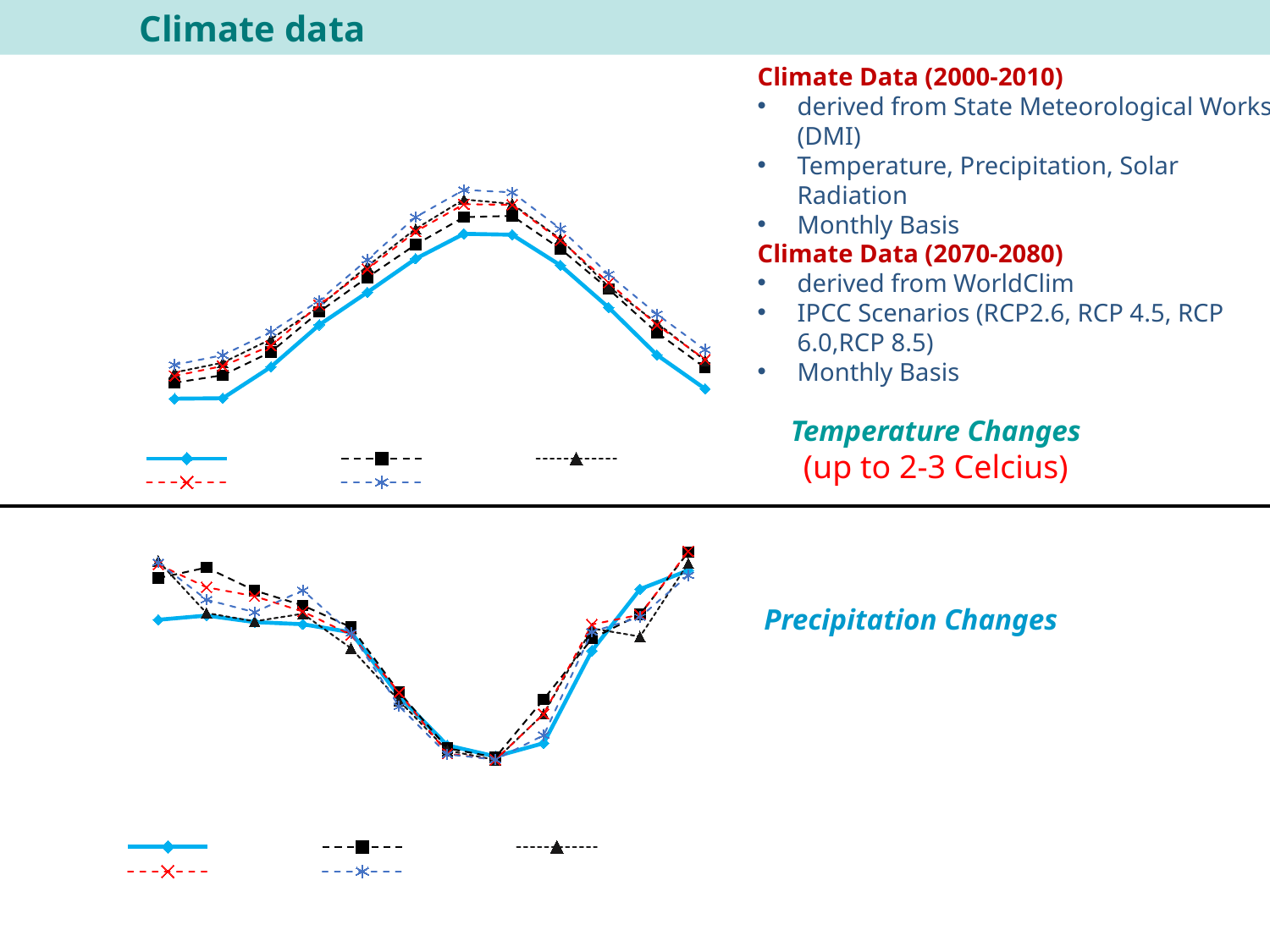
How many series does the legend of the top chart list? 5 How many charts are shown on the slide? 2 In the bottom chart, do the lines rise or fall from the first point to the middle of the x axis? fall What kind of chart is the top chart on the slide? line chart In the top chart, do the lines rise or fall from the middle of the x axis to the last point? fall What kind of chart is the bottom chart on the slide? line chart Which chart on the slide is labelled 'Precipitation Changes', the top one or the bottom one? the bottom one How many data points does each line in the bottom chart have? 12 In the top chart, do the lines rise or fall from the first point to the middle of the x axis? rise How many series does the legend of the bottom chart list? 5 How many data points does each line in the top chart have? 12